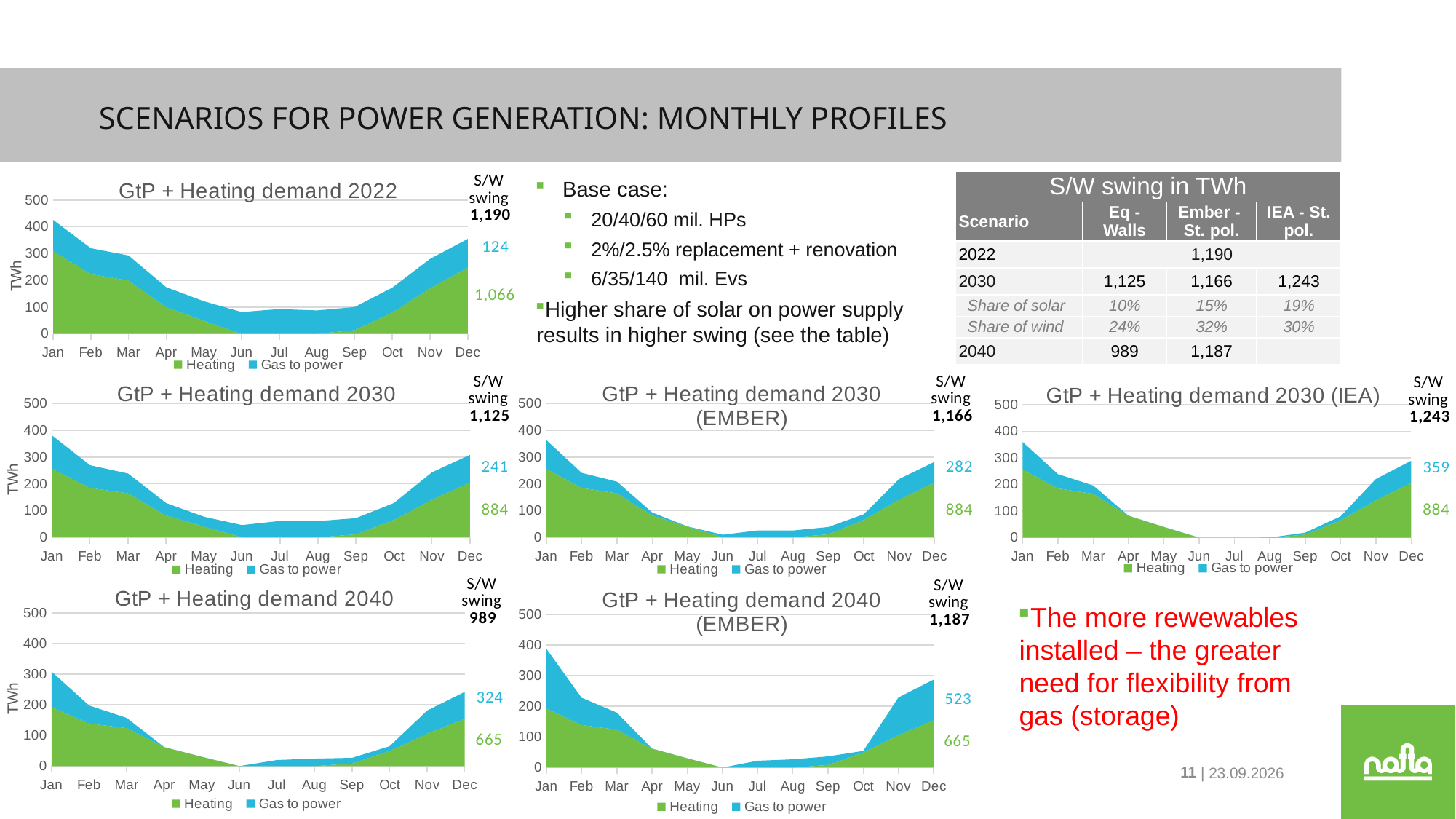
What are the two series named in the legend of the 'GtP + Heating demand 2030' chart? Heating and Gas to power In the 'GtP + Heating demand 2040' chart, is the total demand in Jul greater or less than 100? less What S/W swing value is printed next to the 'GtP + Heating demand 2030 (EMBER)' chart? 1,166 In the 'GtP + Heating demand 2022' chart, which month has the larger total demand, Jan or Dec? Jan What kind of chart is 'GtP + Heating demand 2022'? area chart What S/W swing value is printed next to the 'GtP + Heating demand 2040' chart? 989 In the 'GtP + Heating demand 2030 (IEA)' chart, do the values rise or fall from Jan to Jun? fall In the 'GtP + Heating demand 2022' chart, which month has the highest total demand? Jan In the 'GtP + Heating demand 2022' chart, is the total demand in Jan greater or less than 300? greater How many series does the legend of the 'GtP + Heating demand 2022' chart list? 2 How many months are shown on the x axis of the 'GtP + Heating demand 2040' chart? 12 What is the difference between the S/W swing printed next to the 'GtP + Heating demand 2030 (IEA)' chart (1,243) and the one next to the 'GtP + Heating demand 2030' chart (1,125)? 118